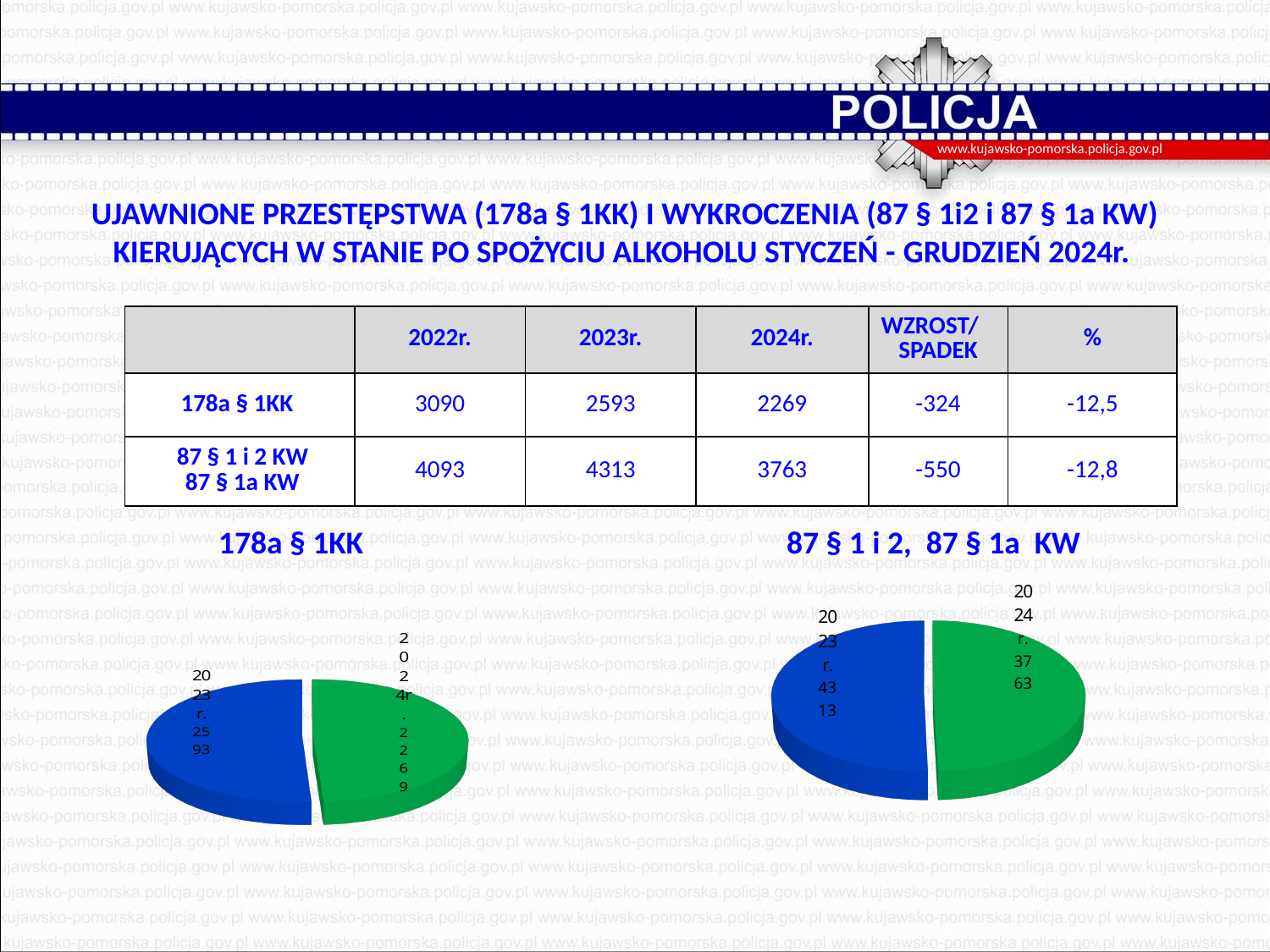
In the pie chart titled "178a § 1KK", what is the value for 2023 r.? 2593 How many slices does the pie chart titled "178a § 1KK" have? 2 In the pie chart titled "87 § 1 i 2, 87 § 1a KW", what is the value for 2023 r.? 4313 In the pie chart titled "87 § 1 i 2, 87 § 1a KW", is the 2023 r. value larger or smaller than the 2024 r. value? Larger What kind of chart is the one titled "178a § 1KK"? Pie chart In the pie chart titled "178a § 1KK", what is the value for 2024 r.? 2269 In the pie chart titled "87 § 1 i 2, 87 § 1a KW", what colour is the 2024 r. slice? Green In the pie chart titled "178a § 1KK", what is the difference between the 2023 r. and 2024 r. values? 324 In the pie chart titled "87 § 1 i 2, 87 § 1a KW", which year has the smaller slice? 2024 r. In the pie chart titled "87 § 1 i 2, 87 § 1a KW", what is the difference between the 2023 r. and 2024 r. values? 550 In the pie chart titled "87 § 1 i 2, 87 § 1a KW", what is the value for 2024 r.? 3763 In the pie chart titled "178a § 1KK", which year has the larger slice? 2023 r.